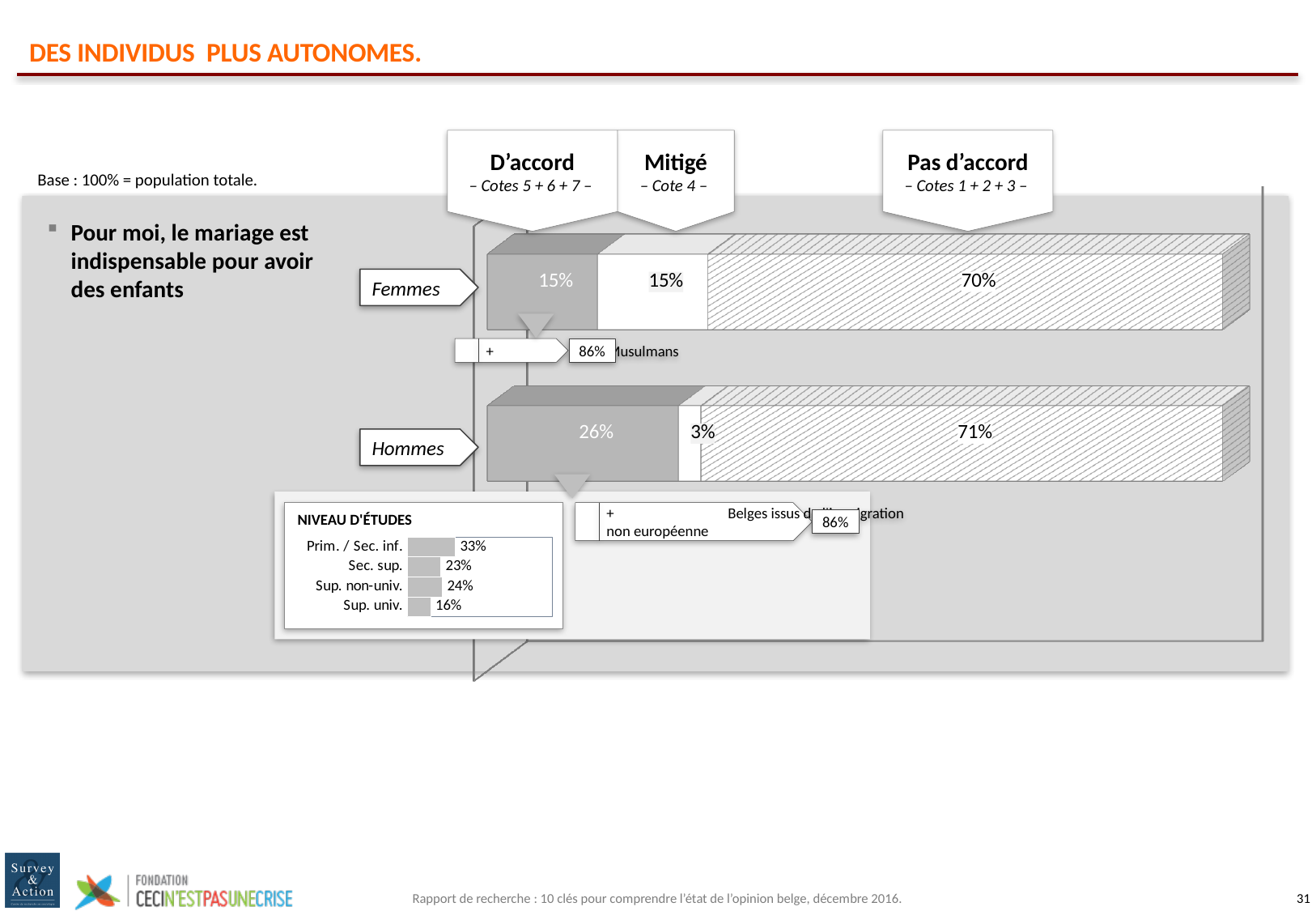
How many response categories (segments) does each bar in the main stacked bar chart contain? 3 In the main stacked bar chart, what percentage of Hommes are 'Pas d'accord'? 71% How many groups (bars) are shown in the main stacked bar chart? 2 In the main stacked bar chart, what is the difference between the 'D'accord' values for Hommes and Femmes? 11 percentage points In the 'NIVEAU D'ÉTUDES' chart, what is the value for Sec. sup.? 23% What type of chart is used to show the Femmes and Hommes results? Stacked bar chart In the main stacked bar chart, what percentage of Femmes are 'D'accord' that marriage is indispensable to have children? 15% In the main stacked bar chart, what is the 'Mitigé' value for Hommes? 3% In the 'NIVEAU D'ÉTUDES' chart, which education level has the lowest value? Sup. univ. In the 'NIVEAU D'ÉTUDES' chart, which education level has the highest value? Prim. / Sec. inf. In the main stacked bar chart, what is the total of the three segments for Femmes? 100% In the main stacked bar chart, which group has the larger 'Mitigé' share, Femmes or Hommes? Femmes